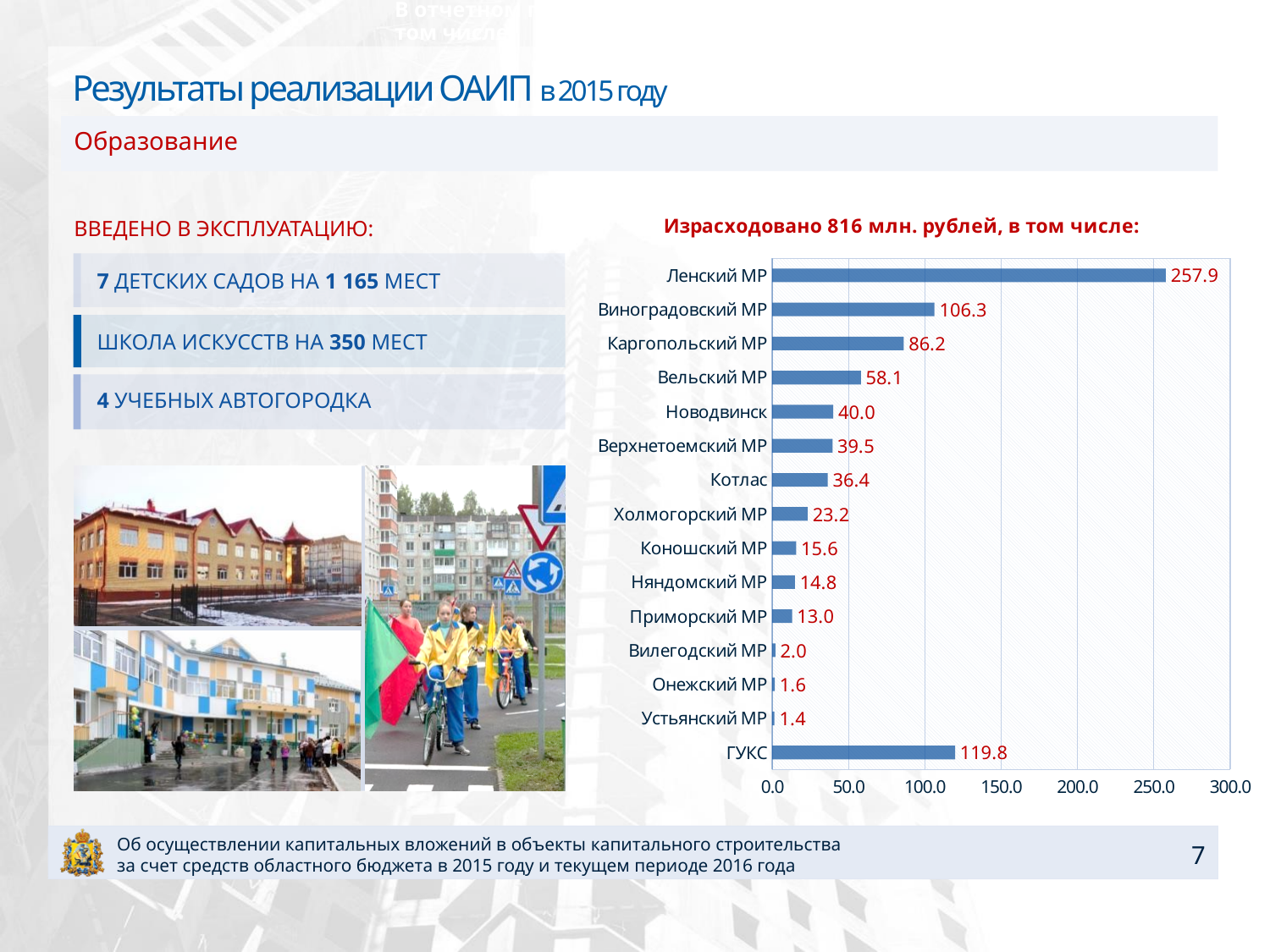
Is the value for Вельский МР greater or less than 50.0? greater What is the difference between the values for Новодвинск and Верхнетоемский МР? 0.5 How many categories are shown in the chart? 15 What kind of chart is shown on the slide? bar chart What value is shown for Ленский МР? 257.9 What value is shown for ГУКС? 119.8 What is the difference between the values for Ленский МР and Виноградовский МР? 151.6 What is the title of the chart? Израсходовано 816 млн. рублей, в том числе: Which is larger, the value for Каргопольский МР or the value for ГУКС? ГУКС Which category has the lowest value? Устьянский МР Which category has the highest value? Ленский МР What value is shown for Котлас? 36.4